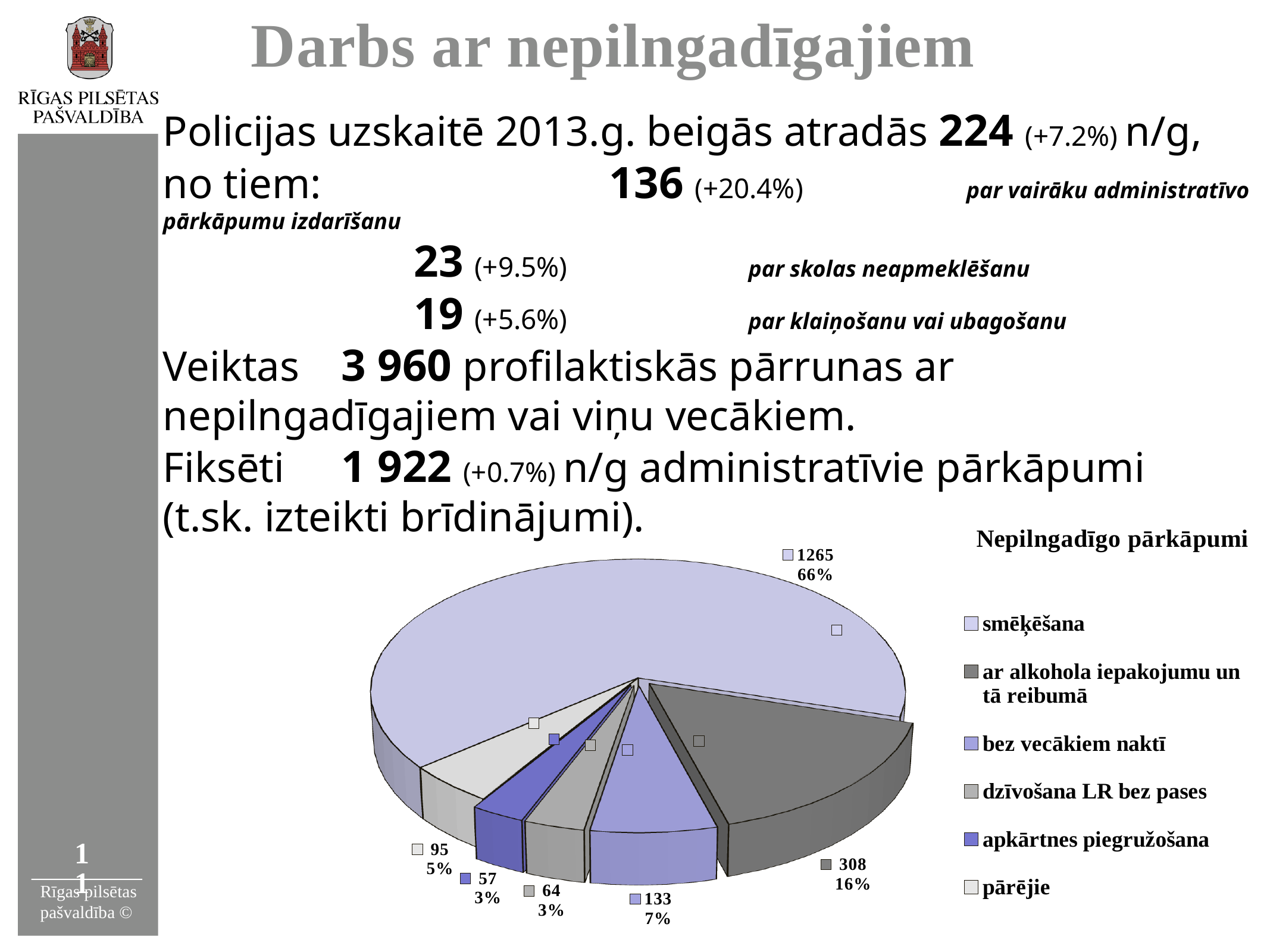
Which category has the largest slice of the pie? smēķēšana What is the title of the chart? Nepilngadīgo pārkāpumi How many categories does the legend of the pie chart list? 6 What is the value for ar alkohola iepakojumu un tā reibumā? 308 Which is larger: the value for dzīvošana LR bez pases or the value for pārējie? pārējie What is the difference between the values for smēķēšana and ar alkohola iepakojumu un tā reibumā? 957 What percentage of the pie is bez vecākiem naktī? 7% What is the value for pārējie in the pie chart? 95 What is the value for smēķēšana in the pie chart? 1265 What share of the pie does smēķēšana represent? 66% What type of chart is shown on the slide? pie chart Which category has the smallest value in the pie chart? apkārtnes piegružošana